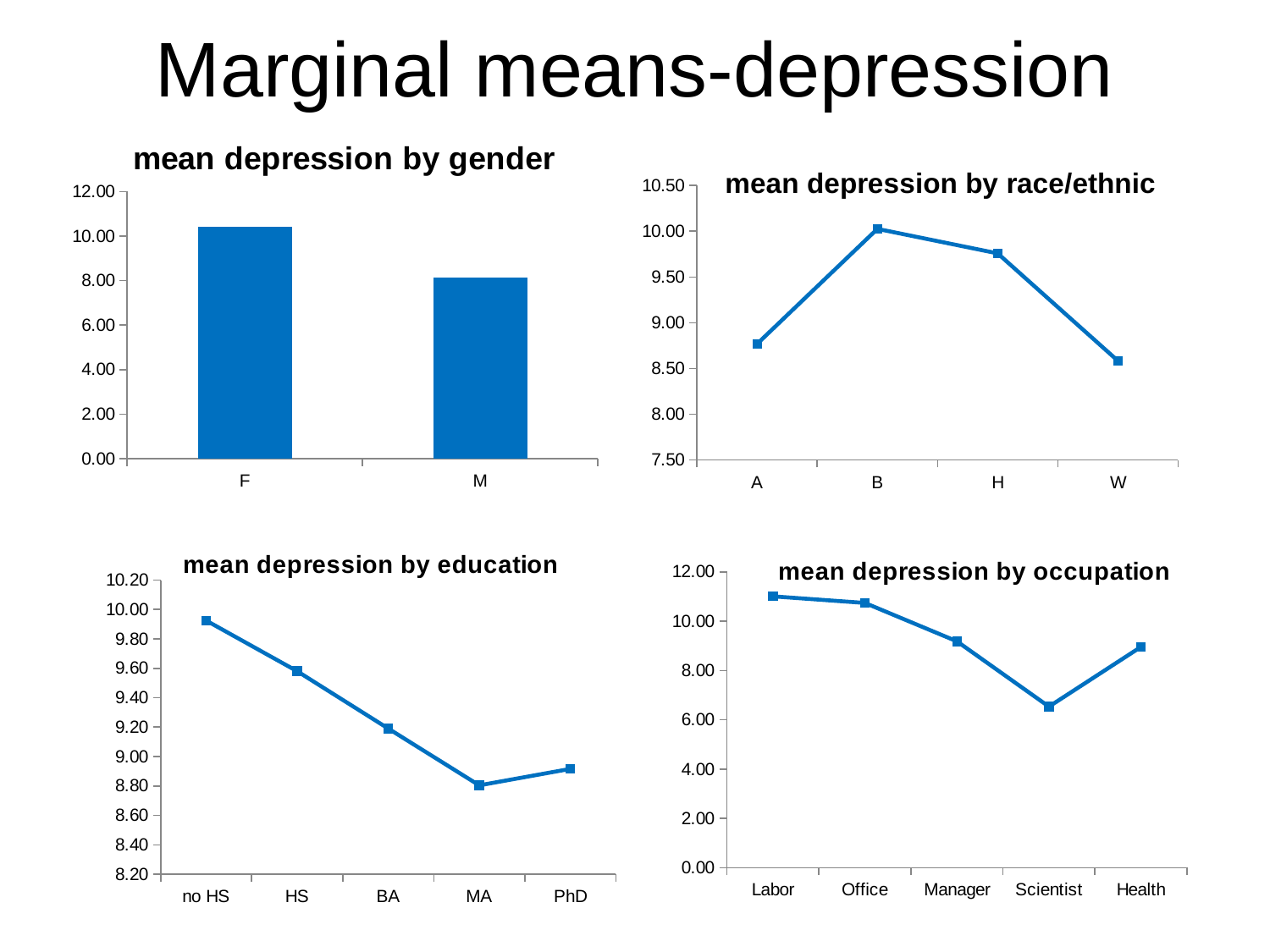
In the 'mean depression by occupation' chart, which category has the lowest value? Scientist In the 'mean depression by race/ethnic' chart, how many categories are plotted? 4 In the 'mean depression by gender' chart, is the value for F greater or less than 10.00? greater In the 'mean depression by education' chart, which category has the lowest value? MA In the 'mean depression by race/ethnic' chart, which category has the highest value? B In the 'mean depression by gender' chart, which category has the higher value, F or M? F In the 'mean depression by education' chart, which category has the highest value? no HS In the 'mean depression by occupation' chart, is the value for Scientist greater or less than 8.00? less In the 'mean depression by gender' chart, is the value for M greater or less than 10.00? less What kind of chart is the 'mean depression by gender' chart? bar chart In the 'mean depression by education' chart, how many categories are plotted? 5